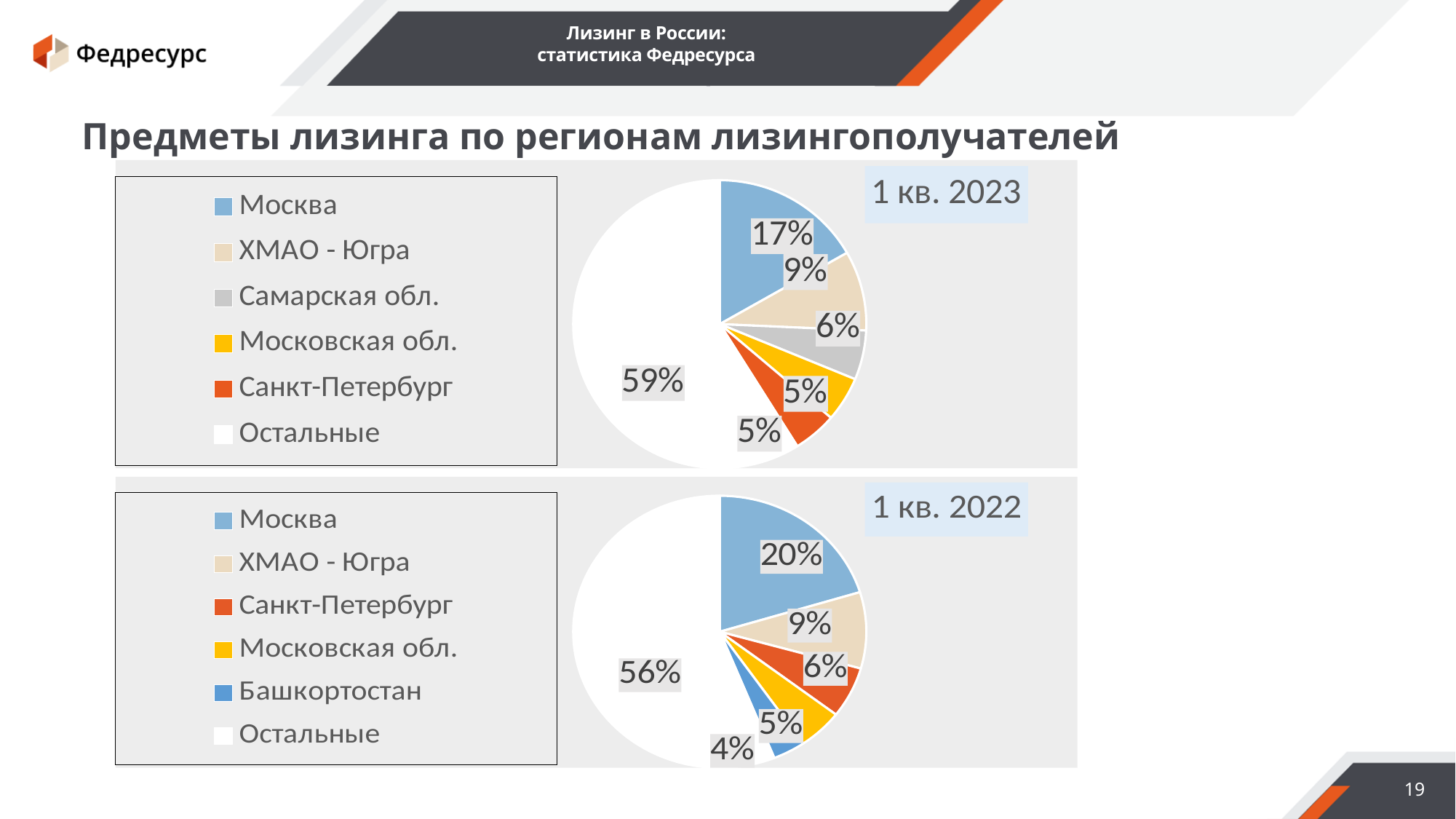
What is the difference between the share of Москва in the 1 кв. 2022 chart and in the 1 кв. 2023 chart? 3% In the 1 кв. 2023 pie chart, which named region (excluding Остальные) has the largest share? Москва In the 1 кв. 2023 pie chart, what share does Москва have? 17% In the 1 кв. 2023 pie chart, what share does Остальные have? 59% Which region appears in the legend of the 1 кв. 2022 chart but not in the 1 кв. 2023 chart? Башкортостан How many categories does the legend of the 1 кв. 2023 chart list? 6 What type of chart is used for the 1 кв. 2022 data? Pie chart In the 1 кв. 2022 pie chart, what share does Башкортостан have? 4% In the 1 кв. 2022 pie chart, what share does Москва have? 20% In the 1 кв. 2022 pie chart, what share does Санкт-Петербург have? 6% In the 1 кв. 2022 pie chart, which category has the smallest share? Башкортостан Which is larger: the share of Остальные in the 1 кв. 2023 chart or in the 1 кв. 2022 chart? 1 кв. 2023